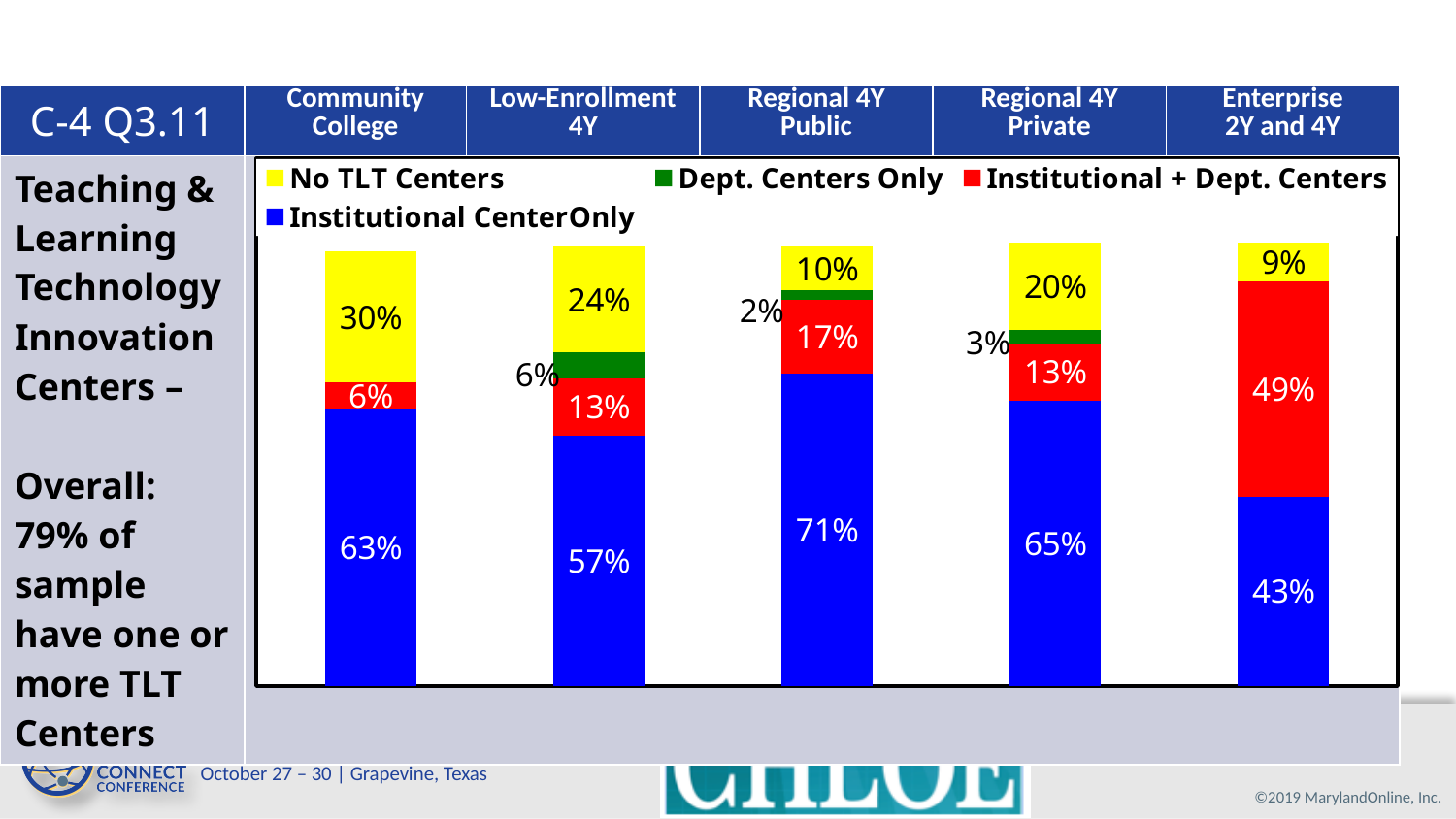
How many series does the legend list? 4 What is the No TLT Centers value for Community College? 30% Which colour represents the No TLT Centers series? yellow What is the Dept. Centers Only value for Low-Enrollment 4Y? 6% What kind of chart is shown on the slide? stacked bar chart How many institution categories are shown in the chart? 5 Which category has the highest Institutional Center Only value? Regional 4Y Public What is the Institutional Center Only value for Regional 4Y Public? 71% Which is larger: the Institutional + Dept. Centers value for Regional 4Y Public or for Regional 4Y Private? Regional 4Y Public Which category has the lowest No TLT Centers value? Enterprise 2Y and 4Y What is the Institutional + Dept. Centers value for Enterprise 2Y and 4Y? 49% What is the difference between the Institutional Center Only values for Regional 4Y Private and Low-Enrollment 4Y? 8%